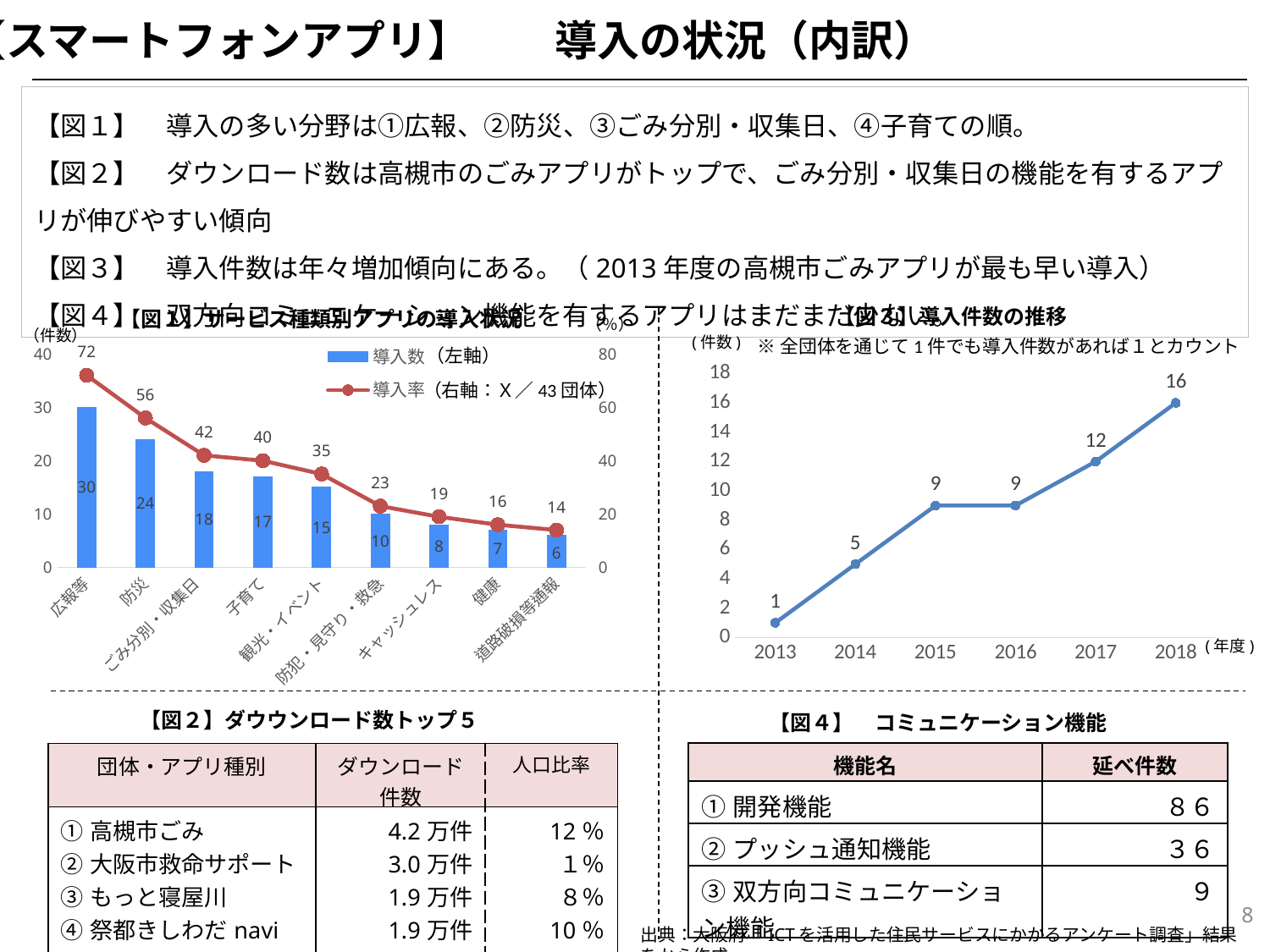
In the 図1 chart on the left, what is the 導入率 value for 防災? 56 In the 図1 chart on the left, which is larger, the 導入数 for 子育て or for 健康? 子育て In the 図3 chart on the right, which year has the highest value? 2018 In the 図1 chart on the left, what is the difference in 導入数 between 広報等 and ごみ分別・収集日? 12 In the 図1 chart on the left, how many categories are shown on the x axis? 9 In the 図3 chart on the right, do the values generally rise or fall from 2013 to 2018? rise What kind of chart is the 図3 chart on the right? line chart In the 図3 chart on the right, what is the difference between the values for 2018 and 2013? 15 In the 図1 chart on the left, what is the 導入数 value for 広報等? 30 In the 図1 chart on the left, which category has the lowest 導入数? 道路破損等通報 In the 図1 chart on the left, how many series does the legend list? 2 In the 図3 chart on the right, what is the value for 2017? 12